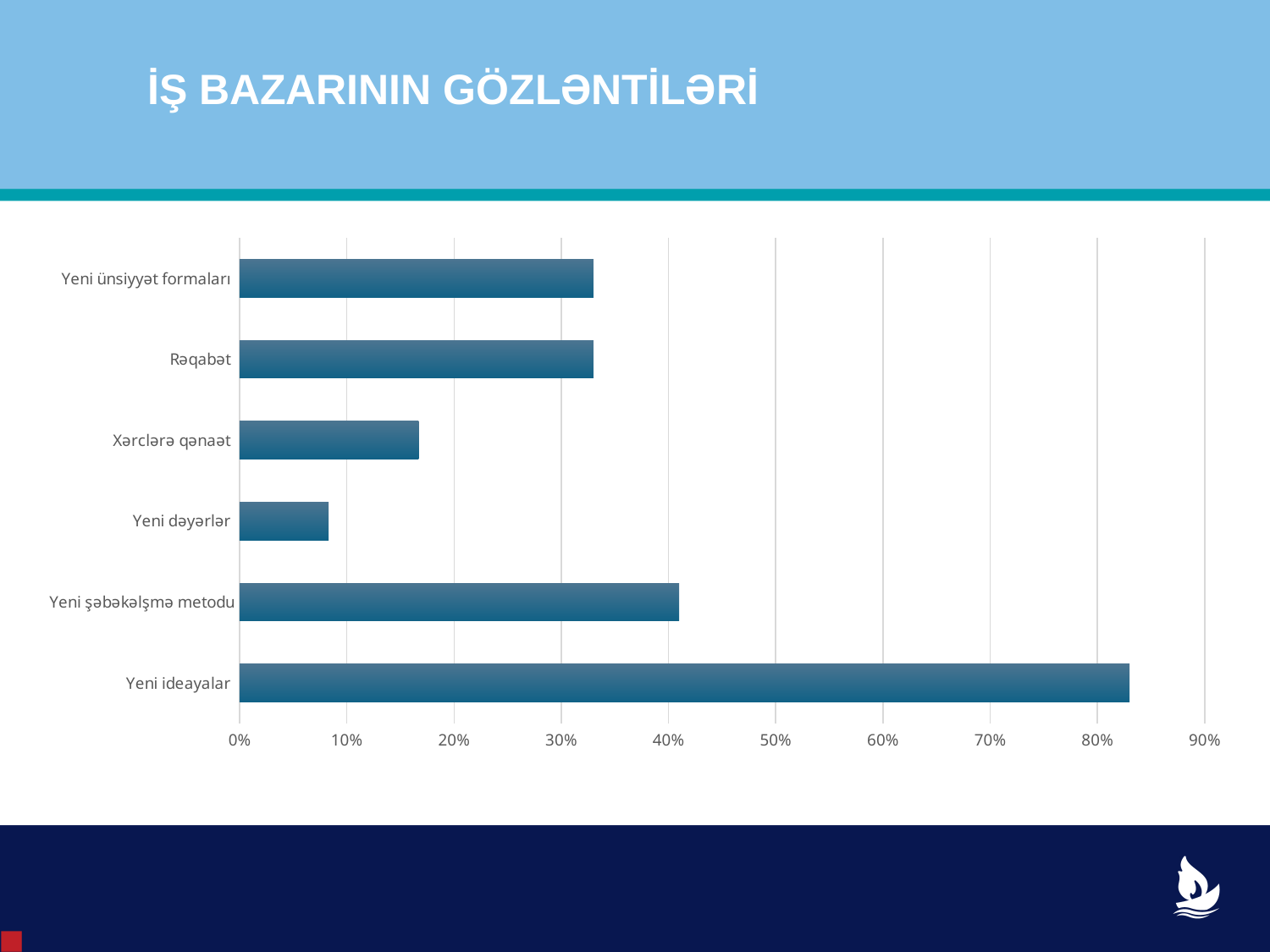
Which category has the lowest value in the chart? Yeni dəyərlər Which is larger, the value for Xərclərə qənaət or the value for Yeni dəyərlər? Xərclərə qənaət Is the value for Rəqabət greater or less than 30%? greater Which category has the highest value in the chart? Yeni ideayalar Which is larger, the value for Yeni ideayalar or the value for Yeni şəbəkələşmə metodu? Yeni ideayalar How many categories are plotted in the chart? 6 Is the value for Xərclərə qənaət greater or less than 20%? less Is the value for Yeni dəyərlər greater or less than 10%? less What kind of chart is shown on the slide? Bar chart What is the title of the slide containing the chart? İŞ BAZARININ GÖZLƏNTİLƏRİ